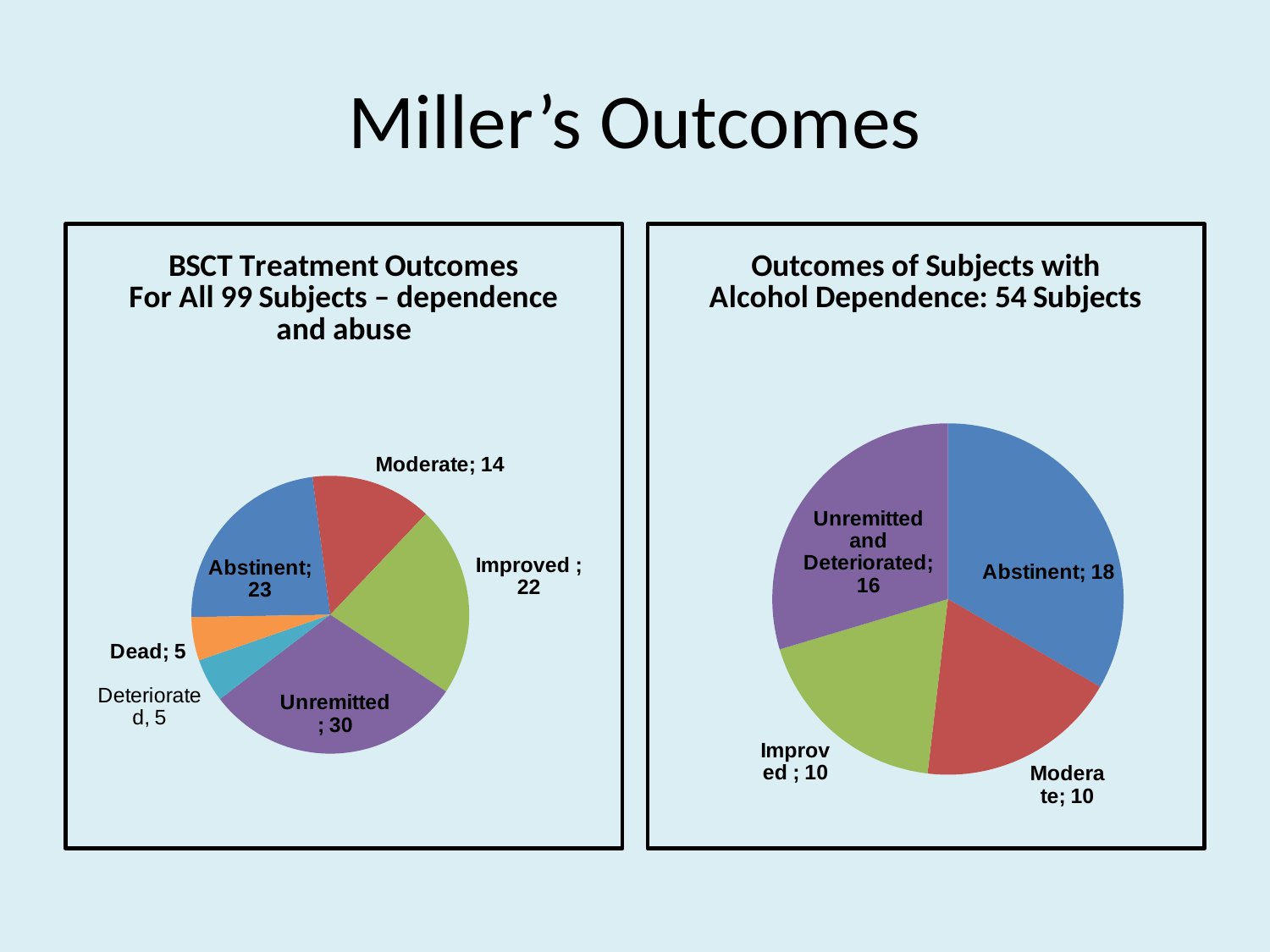
In the Outcomes of Subjects with Alcohol Dependence chart, what is the difference between the Abstinent and Moderate values? 8 In the BSCT Treatment Outcomes chart, how many subjects were Unremitted? 30 In the Outcomes of Subjects with Alcohol Dependence chart, how many slices does the pie have? 4 What type of chart is used on the right side of the slide? Pie chart In the Outcomes of Subjects with Alcohol Dependence chart, how many subjects were Unremitted and Deteriorated? 16 In the Outcomes of Subjects with Alcohol Dependence chart, how many subjects were Abstinent? 18 In the BSCT Treatment Outcomes chart, what is the difference between the Unremitted and Moderate values? 16 In the BSCT Treatment Outcomes chart, which category has the largest slice? Unremitted In the BSCT Treatment Outcomes chart, how many subjects were Abstinent? 23 In the Outcomes of Subjects with Alcohol Dependence chart, which category has the largest slice? Abstinent In the BSCT Treatment Outcomes chart, how many slices does the pie have? 6 In the BSCT Treatment Outcomes chart, which is larger, Abstinent or Improved? Abstinent